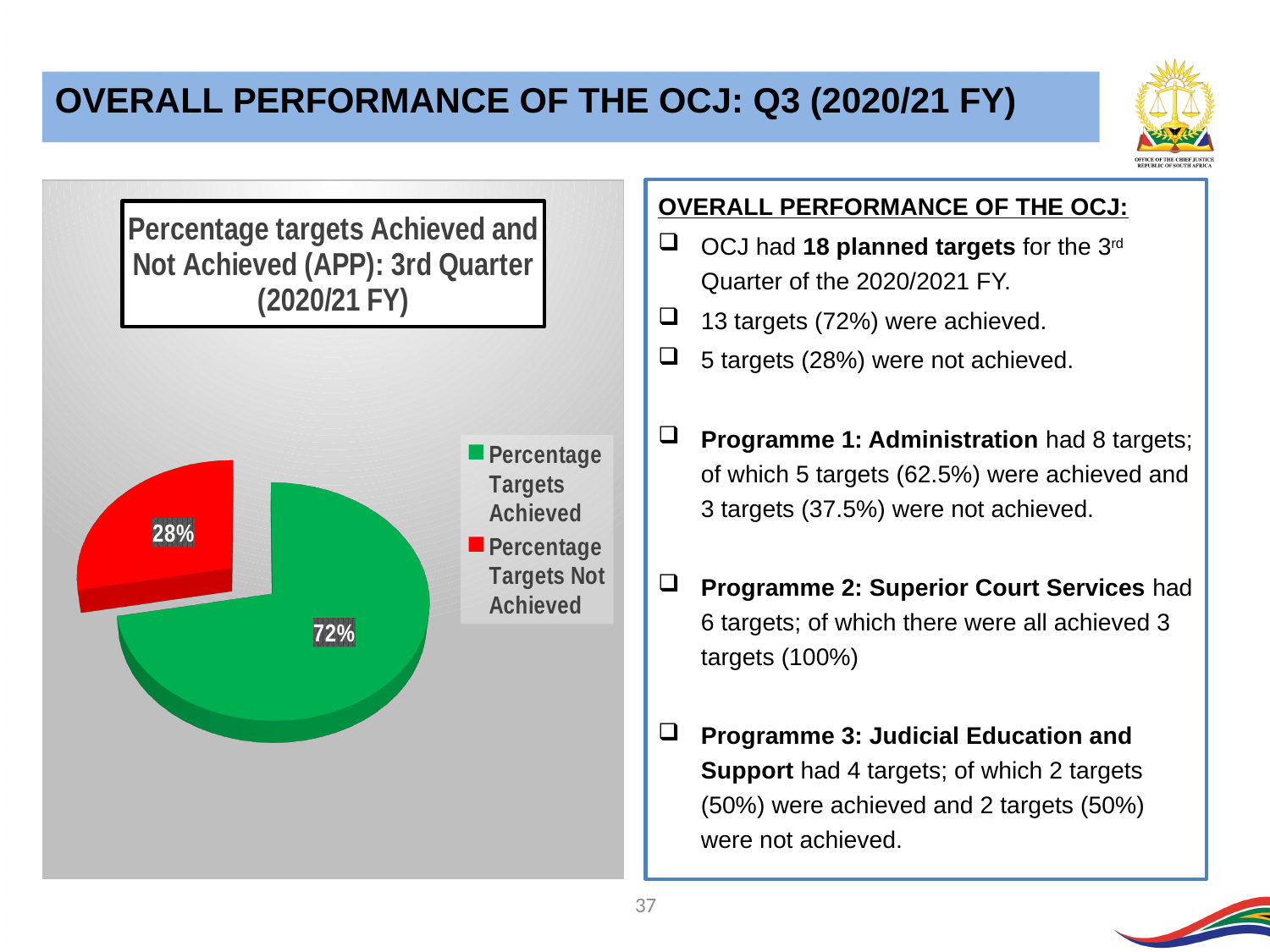
What is the difference in percentage points between the Percentage Targets Achieved slice and the Percentage Targets Not Achieved slice? 44 percentage points What colour is the Percentage Targets Not Achieved slice in the pie chart? Red What kind of chart is shown on the slide? Pie chart Which slice of the pie chart is the smallest? Percentage Targets Not Achieved Which is larger: the Percentage Targets Achieved slice or the Percentage Targets Not Achieved slice? Percentage Targets Achieved How many entries does the legend of the pie chart list? 2 What is the title of the pie chart? Percentage targets Achieved and Not Achieved (APP): 3rd Quarter (2020/21 FY) What percentage of targets were achieved according to the pie chart? 72% How many slices does the pie chart have? 2 Which slice of the pie chart is the largest? Percentage Targets Achieved What percentage of targets were not achieved according to the pie chart? 28% What share of the pie does the Percentage Targets Achieved slice represent? 72%